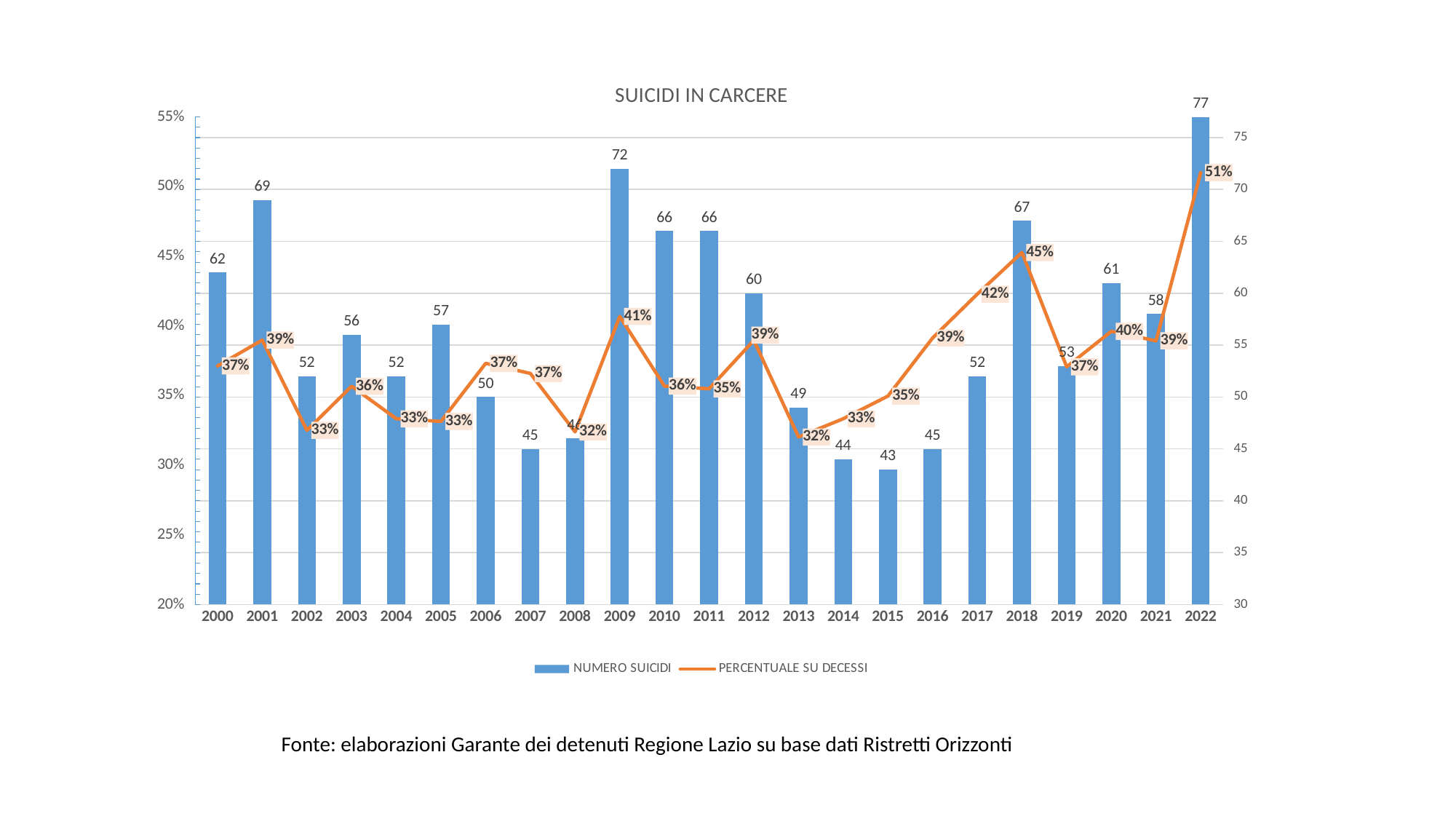
Which is larger, the NUMERO SUICIDI for 2001 or for 2018? 2001 What is the title of the chart? SUICIDI IN CARCERE What kind of chart is used for the NUMERO SUICIDI series? Bar chart What is the NUMERO SUICIDI value for 2009? 72 Which year has the lowest NUMERO SUICIDI? 2015 What is the PERCENTUALE SU DECESSI value for 2013? 32% Which year has the highest PERCENTUALE SU DECESSI? 2022 How many years are shown on the x axis? 23 Which year has the highest NUMERO SUICIDI? 2022 How many series does the legend list? 2 What is the difference in NUMERO SUICIDI between 2022 and 2021? 19 What is the PERCENTUALE SU DECESSI value for 2018? 45%